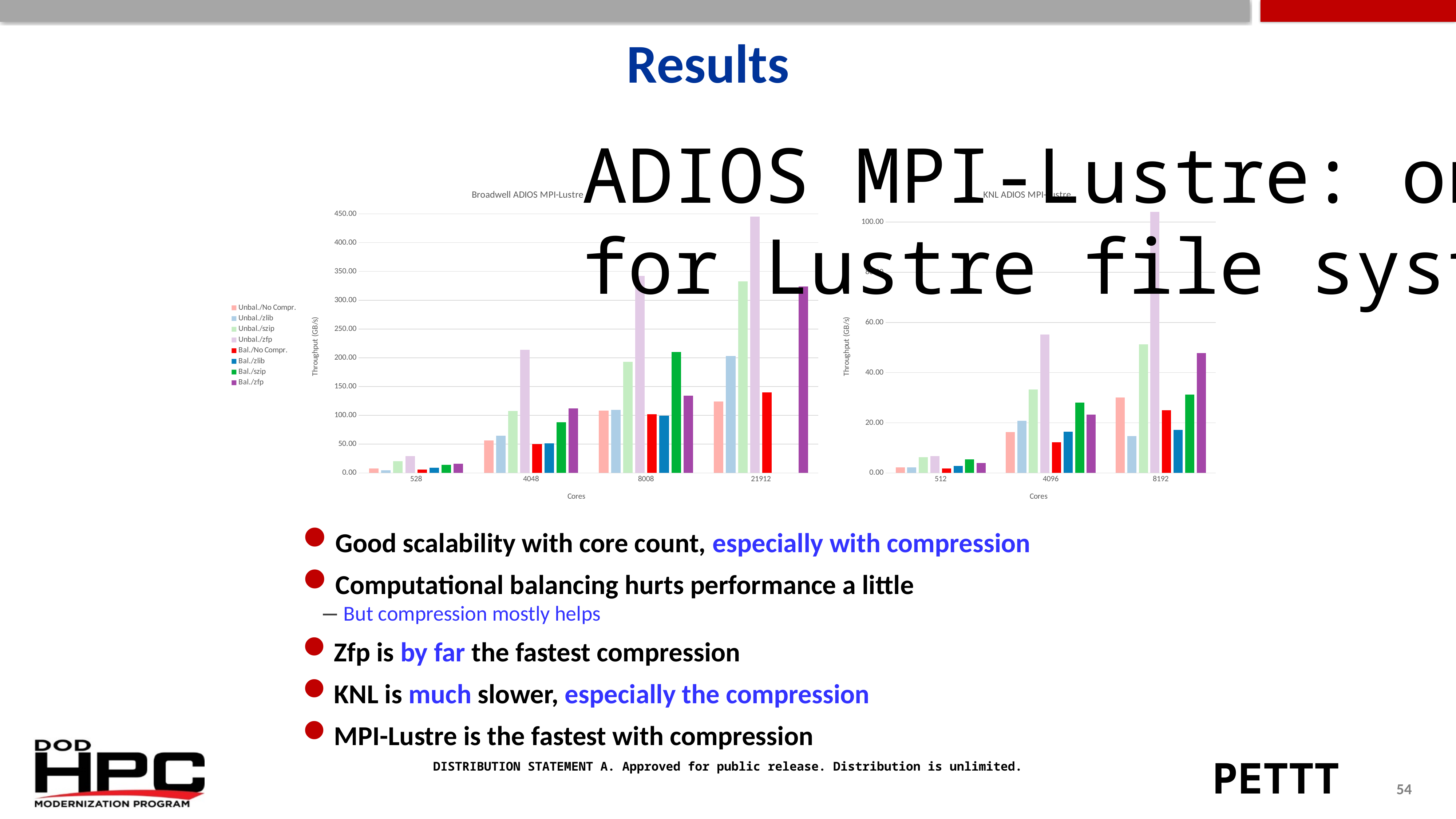
In the Broadwell ADIOS MPI-Lustre chart, how many core-count categories are shown on the x axis? 4 In the Broadwell ADIOS MPI-Lustre chart, is the Unbal./zfp value at 4048 cores greater or less than 200? greater In the Broadwell ADIOS MPI-Lustre chart, at 8008 cores, which is larger: Unbal./zfp or Bal./zfp? Unbal./zfp In the KNL ADIOS MPI-Lustre chart, is the Unbal./zfp value at 4096 cores greater or less than 40? greater In the Broadwell ADIOS MPI-Lustre chart, is the Bal./No Compr. value at 21912 cores greater or less than 150? less In the KNL ADIOS MPI-Lustre chart, at 4096 cores, which is larger: Unbal./zfp or Bal./zfp? Unbal./zfp In the KNL ADIOS MPI-Lustre chart, how many core-count categories are shown on the x axis? 3 In the Broadwell ADIOS MPI-Lustre chart, at which core count is the Unbal./zfp bar highest? 21912 What kind of chart is the Broadwell ADIOS MPI-Lustre chart? Bar chart How many series does the legend list for the charts? 8 In the Broadwell ADIOS MPI-Lustre chart, does the Unbal./zfp throughput rise or fall as the core count increases? Rises